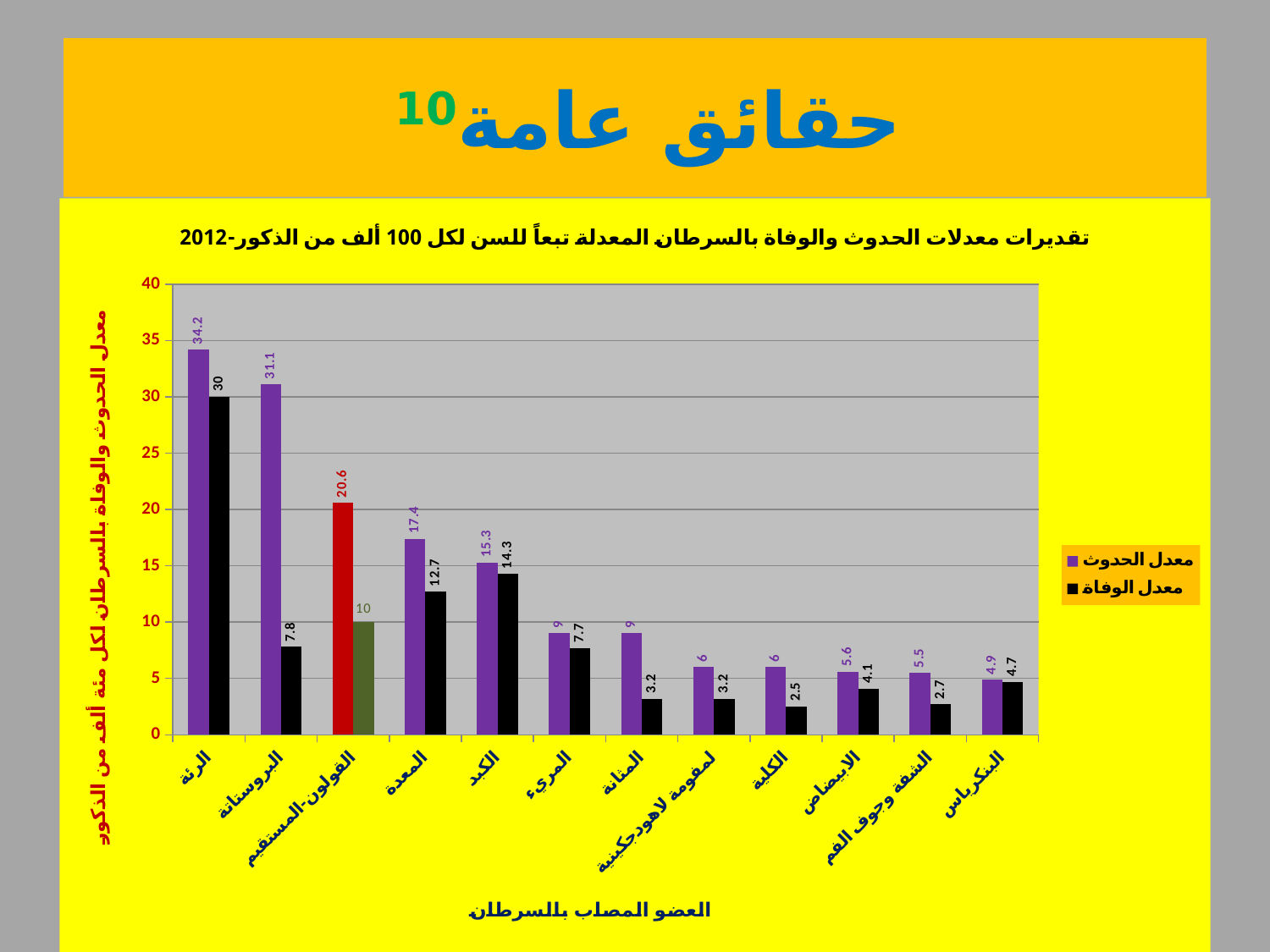
What is the difference between the incidence rate and the mortality rate for البروستاتة? 23.3 Which organ has the lowest mortality rate (معدل الوفاة)? الكلية What is the mortality rate (معدل الوفاة) for البروستاتة? 7.8 Is the incidence rate for المعدة greater or less than 15? greater What is the incidence rate (معدل الحدوث) for الرئة? 34.2 What kind of chart is shown on the slide? bar chart How many series does the legend list? 2 What is the mortality rate (معدل الوفاة) for الكبد? 14.3 What is the incidence rate (معدل الحدوث) for القولون-المستقيم? 20.6 Which is larger: the mortality rate for المعدة or the mortality rate for الكبد? الكبد Which organ has the highest incidence rate (معدل الحدوث)? الرئة How many organ categories are shown on the x axis? 12